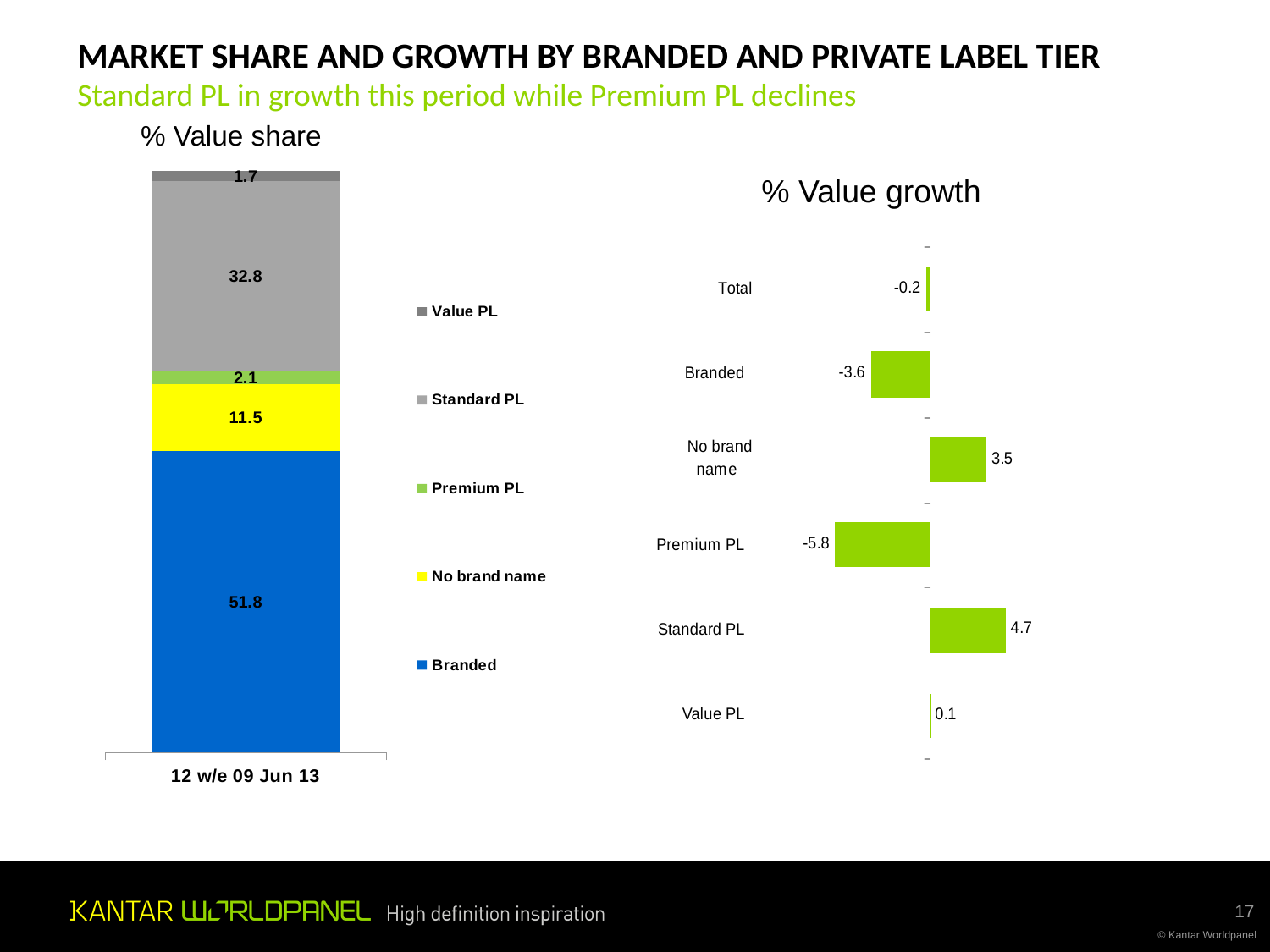
In the % Value share chart, what is the difference between the Branded and Standard PL shares? 19.0 In the % Value share chart, what is the total of the stacked bar for 12 w/e 09 Jun 13? 99.9 In the % Value share chart, which segment has the smallest share? Value PL In the % Value growth chart, which category has the highest growth? Standard PL In the % Value growth chart, which is larger, the growth for No brand name or for Branded? No brand name What kind of chart is the % Value growth chart? Bar chart In the % Value share chart, what is the value share for Standard PL? 32.8 In the % Value growth chart, what is the value growth for Premium PL? -5.8 In the % Value share chart, what is the value share for Branded? 51.8 In the % Value growth chart, what is the value growth for Standard PL? 4.7 In the % Value growth chart, which category has the lowest growth? Premium PL In the % Value share chart, how many series does the legend list? 5